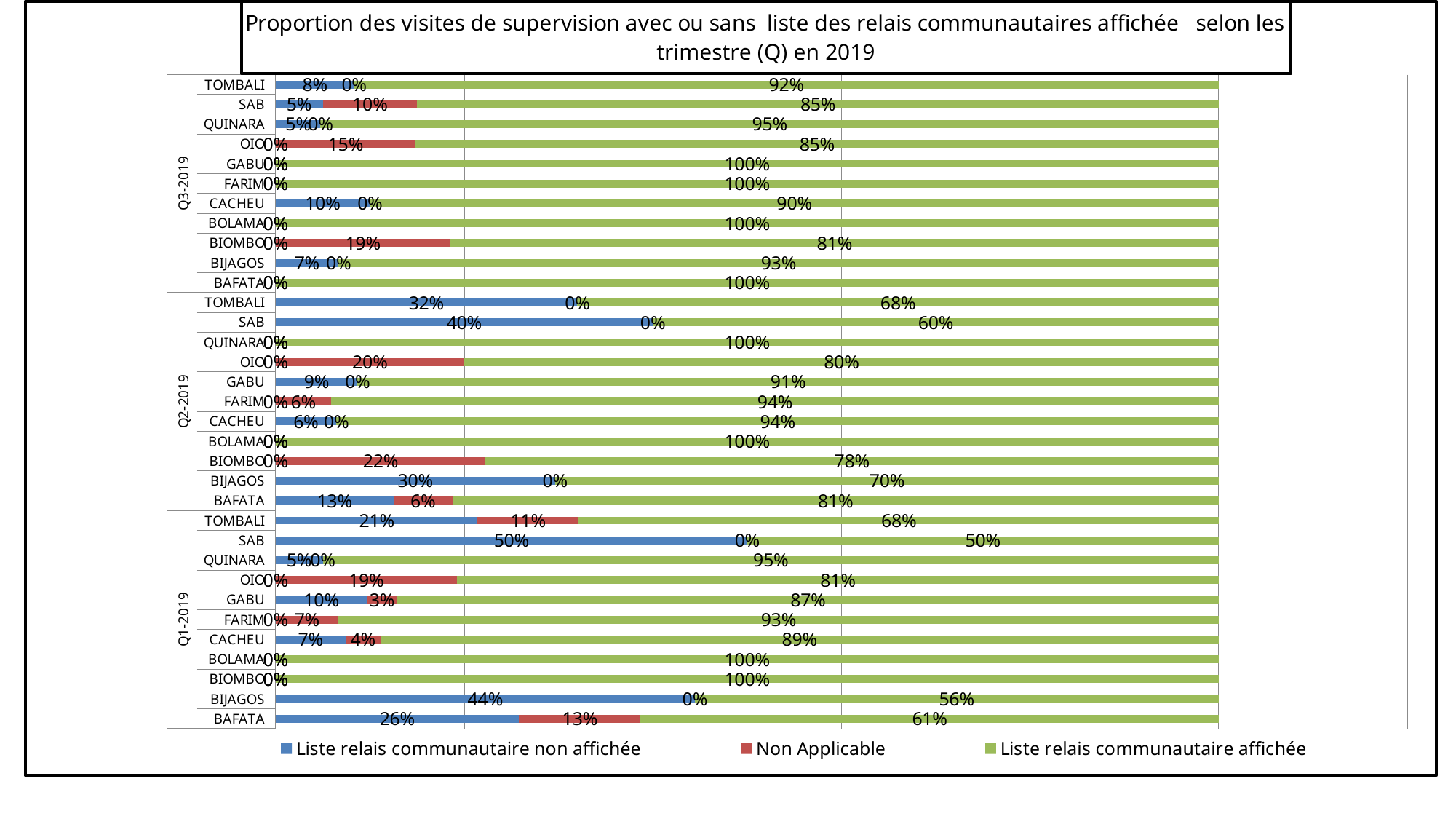
How many regions are listed within each quarter group? 11 What type of chart is shown on the slide? Stacked bar chart How many series does the legend list? 3 In Q2-2019, which has the larger 'Liste relais communautaire non affichée' value, TOMBALI or SAB? SAB What is the 'Liste relais communautaire non affichée' value for BIJAGOS in Q1-2019? 44% What is the difference between the 'Liste relais communautaire affichée' value for SAB in Q3-2019 and in Q1-2019? 35 percentage points What is the 'Non Applicable' value for OIO in Q2-2019? 20% What is the value of 'Liste relais communautaire non affichée' for BAFATA in Q1-2019? 26% What is the value of 'Liste relais communautaire affichée' for SAB in Q3-2019? 85% What is the total of the stacked bar for BAFATA in Q1-2019? 100% In Q1-2019, which region has the highest 'Liste relais communautaire non affichée' value? SAB In Q2-2019, which region has the lowest 'Liste relais communautaire affichée' value? SAB